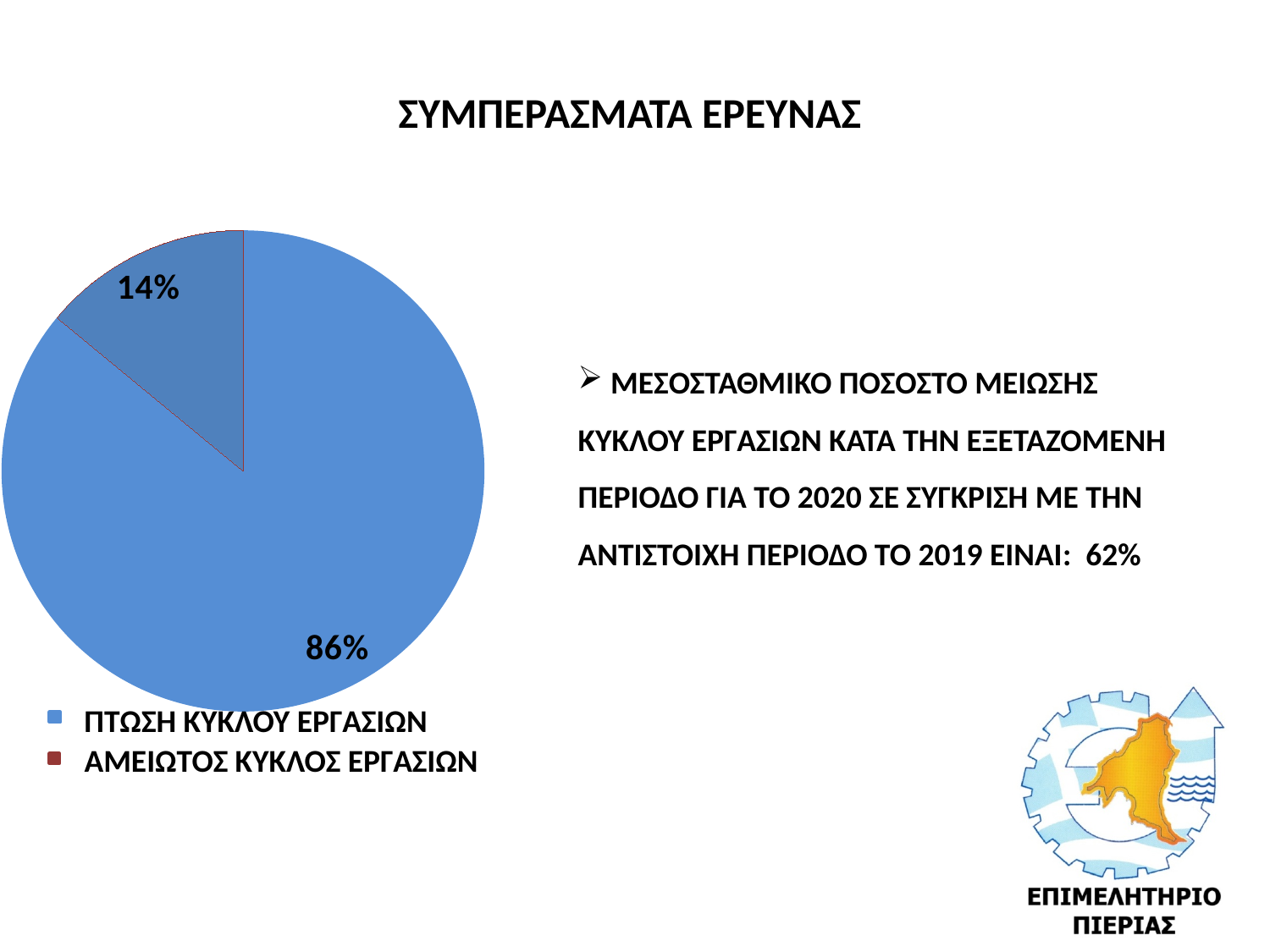
What is the combined share of the two slices in the pie chart? 100% How many entries does the chart legend list? 2 Which category has the smallest slice of the pie? ΑΜΕΙΩΤΟΣ ΚΥΚΛΟΣ ΕΡΓΑΣΙΩΝ Which category has the largest slice of the pie? ΠΤΩΣΗ ΚΥΚΛΟΥ ΕΡΓΑΣΙΩΝ What is the difference in percentage points between the ΠΤΩΣΗ ΚΥΚΛΟΥ ΕΡΓΑΣΙΩΝ slice and the ΑΜΕΙΩΤΟΣ ΚΥΚΛΟΣ ΕΡΓΑΣΙΩΝ slice? 72 percentage points What share of the pie does ΑΜΕΙΩΤΟΣ ΚΥΚΛΟΣ ΕΡΓΑΣΙΩΝ represent? 14% How many slices does the pie chart have? 2 What is the title of the slide containing the pie chart? ΣΥΜΠΕΡΑΣΜΑΤΑ ΕΡΕΥΝΑΣ Which is larger, the slice for ΠΤΩΣΗ ΚΥΚΛΟΥ ΕΡΓΑΣΙΩΝ or the slice for ΑΜΕΙΩΤΟΣ ΚΥΚΛΟΣ ΕΡΓΑΣΙΩΝ? ΠΤΩΣΗ ΚΥΚΛΟΥ ΕΡΓΑΣΙΩΝ Which legend entry is shown with a blue marker? ΠΤΩΣΗ ΚΥΚΛΟΥ ΕΡΓΑΣΙΩΝ What share of the pie does ΠΤΩΣΗ ΚΥΚΛΟΥ ΕΡΓΑΣΙΩΝ represent? 86% What type of chart is shown on the slide? Pie chart